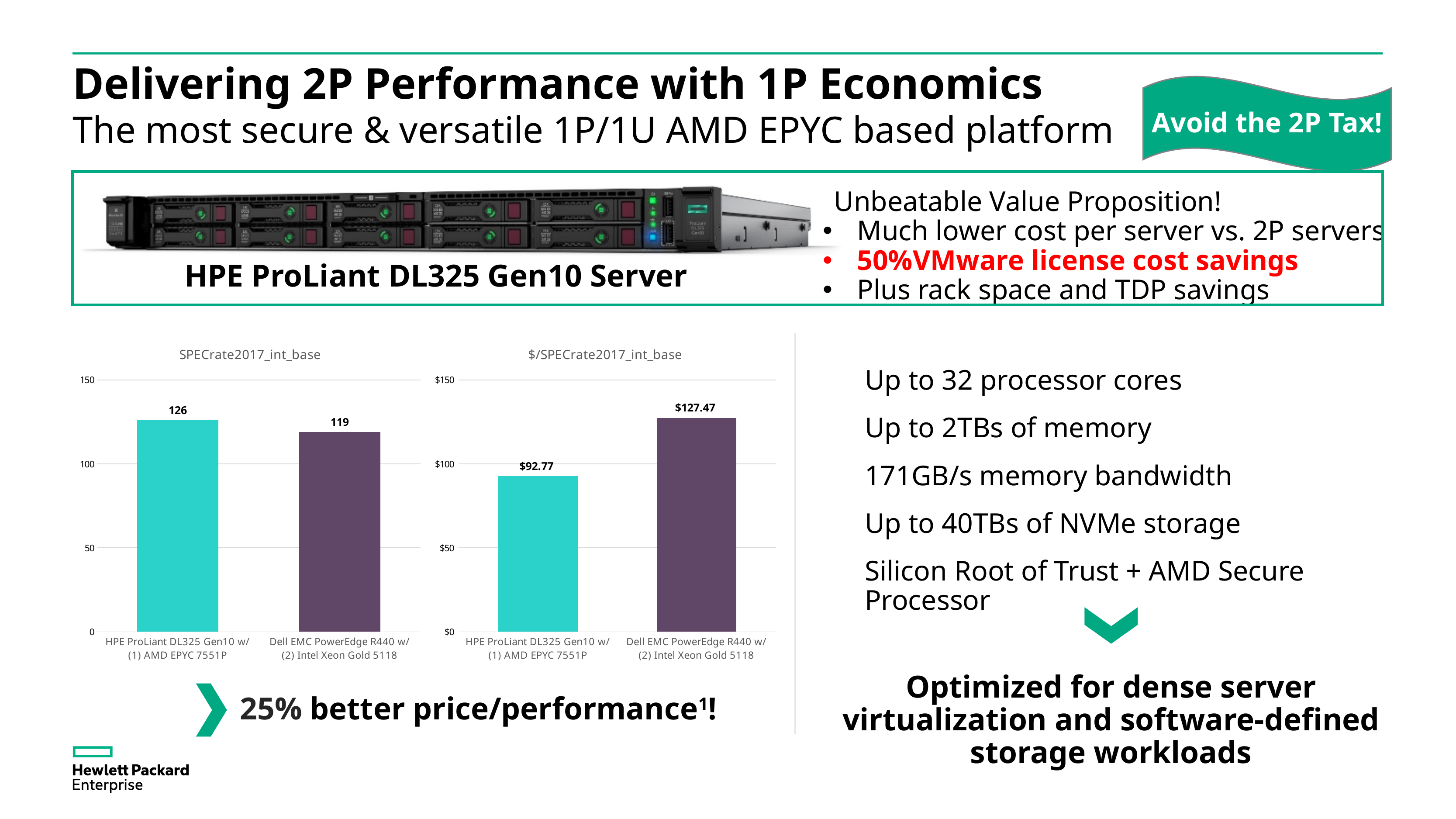
How many categories are shown in the SPECrate2017_int_base chart? 2 In the SPECrate2017_int_base chart, what is the difference between the HPE ProLiant DL325 Gen10 value and the Dell EMC PowerEdge R440 value? 7 What is the title of the left chart on the slide? SPECrate2017_int_base In the $/SPECrate2017_int_base chart, is the value for Dell EMC PowerEdge R440 w/ (2) Intel Xeon Gold 5118 greater or less than $100? greater In the SPECrate2017_int_base chart, what is the value for Dell EMC PowerEdge R440 w/ (2) Intel Xeon Gold 5118? 119 What kind of chart is the $/SPECrate2017_int_base chart? Bar chart In the $/SPECrate2017_int_base chart, what is the value for HPE ProLiant DL325 Gen10 w/ (1) AMD EPYC 7551P? $92.77 In the SPECrate2017_int_base chart, which system has the higher value? HPE ProLiant DL325 Gen10 w/ (1) AMD EPYC 7551P In the $/SPECrate2017_int_base chart, what is the difference between the Dell EMC PowerEdge R440 value and the HPE ProLiant DL325 Gen10 value? $34.70 In the SPECrate2017_int_base chart, what is the value for HPE ProLiant DL325 Gen10 w/ (1) AMD EPYC 7551P? 126 In the $/SPECrate2017_int_base chart, what is the value for Dell EMC PowerEdge R440 w/ (2) Intel Xeon Gold 5118? $127.47 In the $/SPECrate2017_int_base chart, which system has the lower value? HPE ProLiant DL325 Gen10 w/ (1) AMD EPYC 7551P